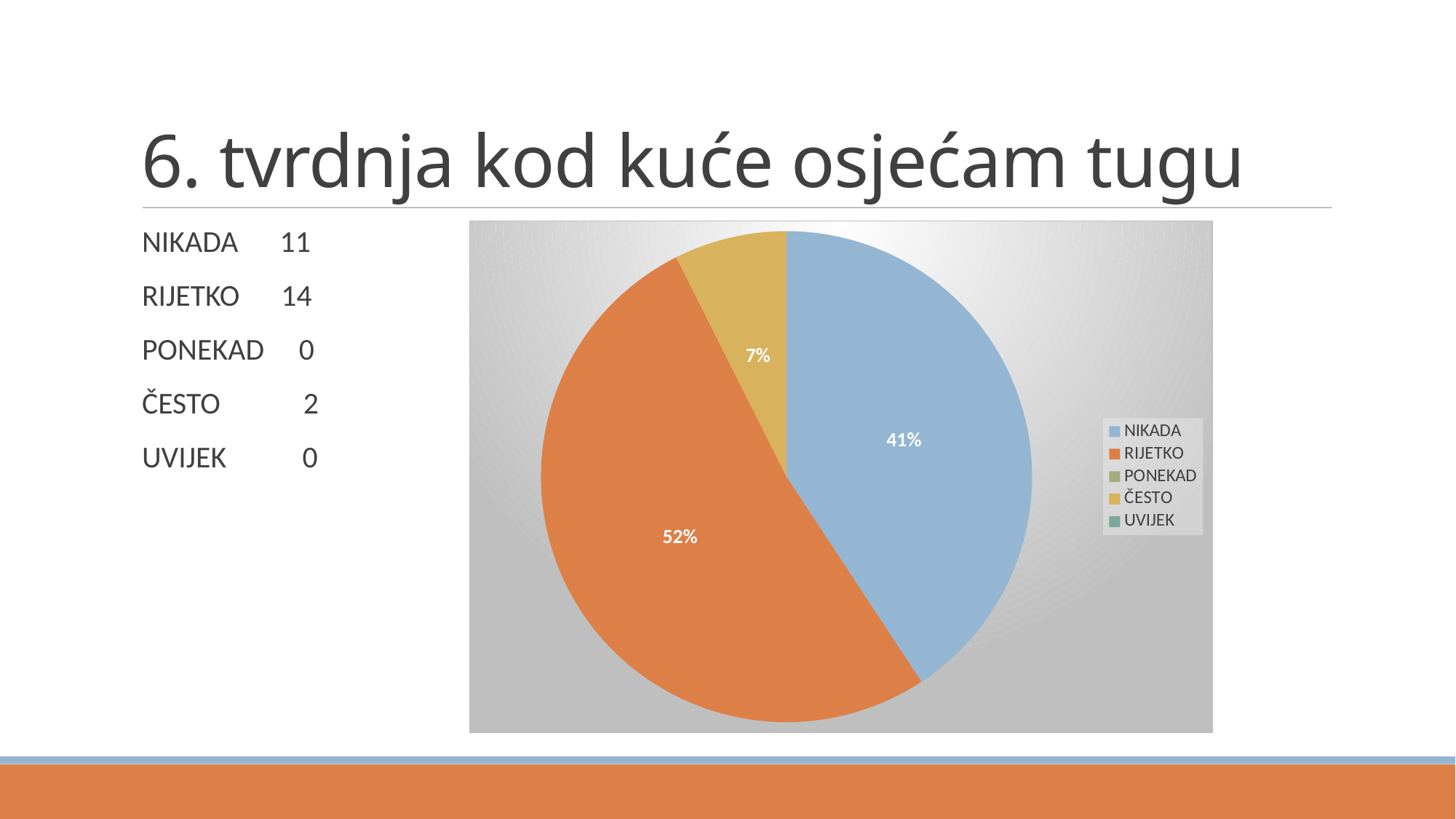
What share of the pie does ČESTO take? 7% What colour is the RIJETKO slice? orange Which category has the largest slice of the pie? RIJETKO What is the difference in percentage points between the RIJETKO and NIKADA slices? 11% Which slice is larger, NIKADA or RIJETKO? RIJETKO How many entries does the legend list? 5 What share of the pie does RIJETKO take? 52% What kind of chart is shown on the slide? pie chart How many slices are visible in the pie? 3 Which of the visible slices is the smallest? ČESTO What share of the pie does NIKADA take? 41% What is the title of the slide containing the chart? 6. tvrdnja kod kuće osjećam tugu